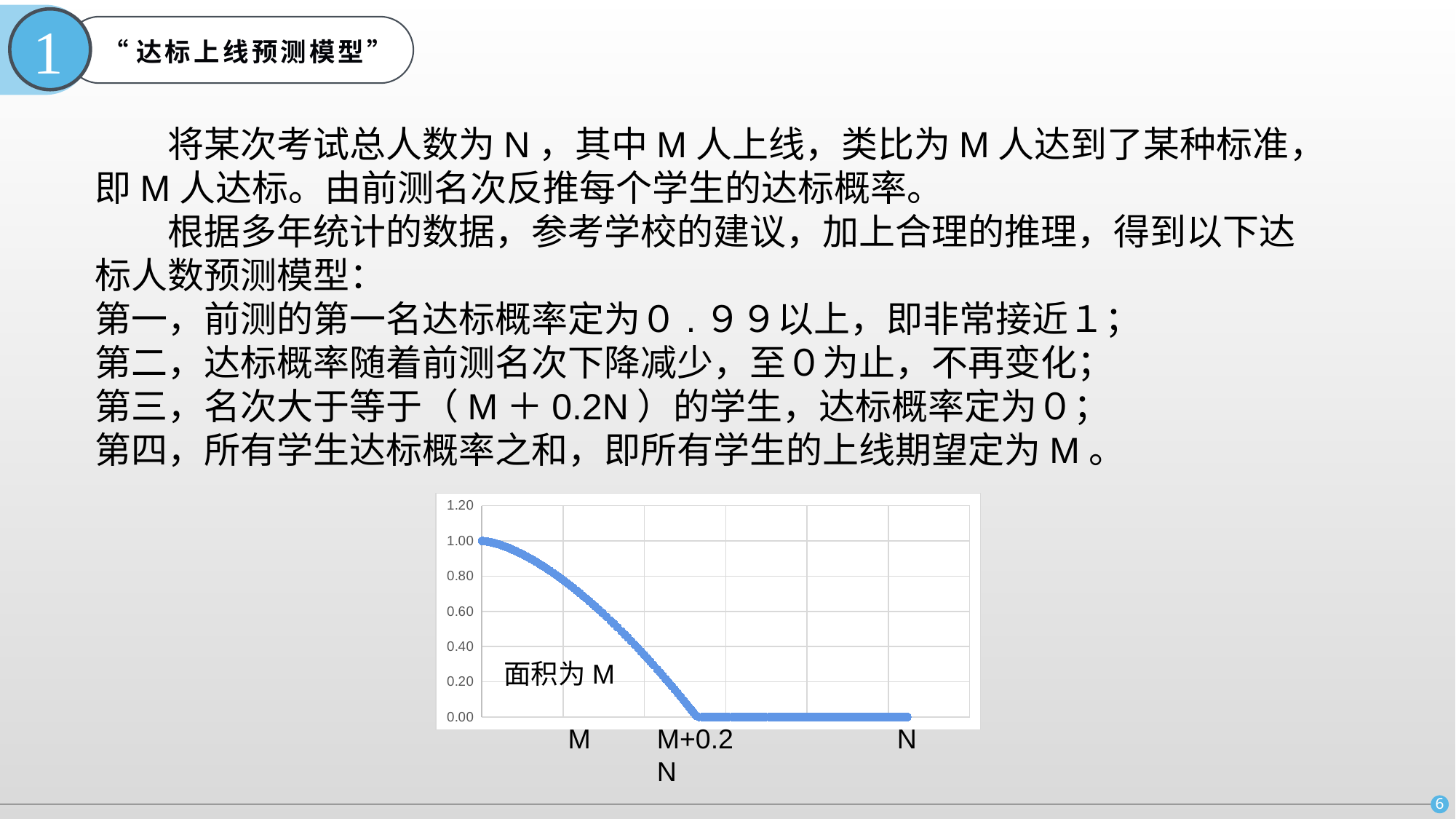
Is the plotted value at the x-axis position labelled M greater or less than 0.40? greater What kind of chart is shown on the slide? line chart Which is larger, the plotted value at M or the plotted value at N? the value at M What is the highest tick value shown on the y axis of the chart? 1.20 What is the plotted value at the x-axis position labelled M+0.2N? 0.00 What text annotation is written inside the chart area? 面积为 M How many labelled positions are shown on the x axis of the chart? 3 What is the plotted value at the x-axis position labelled N? 0.00 What is the plotted value at the left end of the curve (the first rank)? 1.00 Do the plotted values rise or fall as you move from the left of the x axis toward M+0.2N? fall What is the lowest plotted value on the chart? 0.00